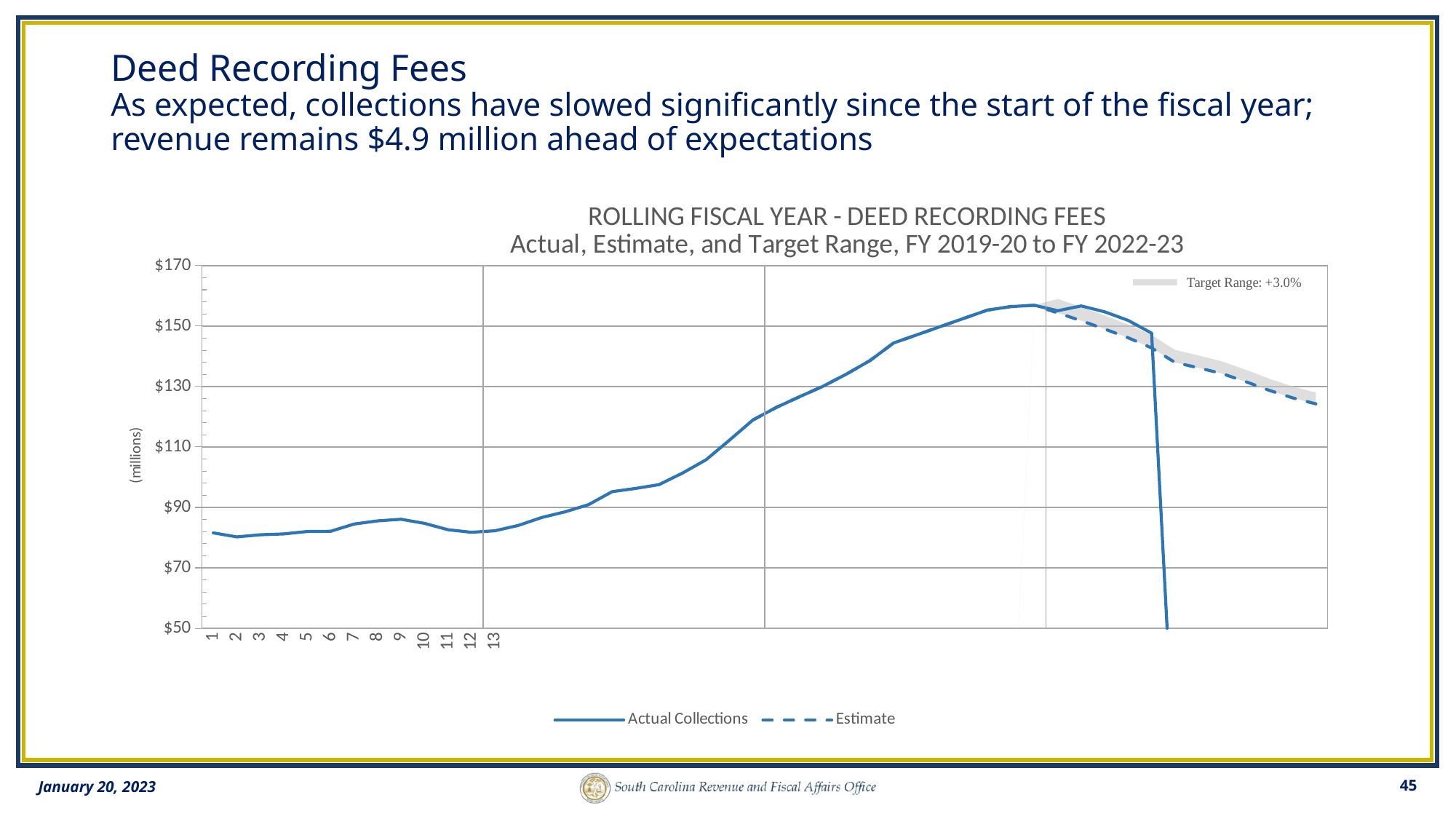
Is the Estimate value at the far right end of the chart greater or less than $110? greater Is the Actual Collections value at point 1 greater or less than $90? less Does the Actual Collections line rise or fall between point 13 and its peak? rise Is the peak value of the Actual Collections line greater or less than $150? greater What is the lowest value shown on the y axis? $50 What are the two series named in the chart legend? Actual Collections and Estimate What kind of chart is shown on the slide? line chart Does the Estimate line rise or fall as it moves toward the right end of the chart? fall How many series does the chart legend list? 2 What is the title of the chart? ROLLING FISCAL YEAR - DEED RECORDING FEES Actual, Estimate, and Target Range, FY 2019-20 to FY 2022-23